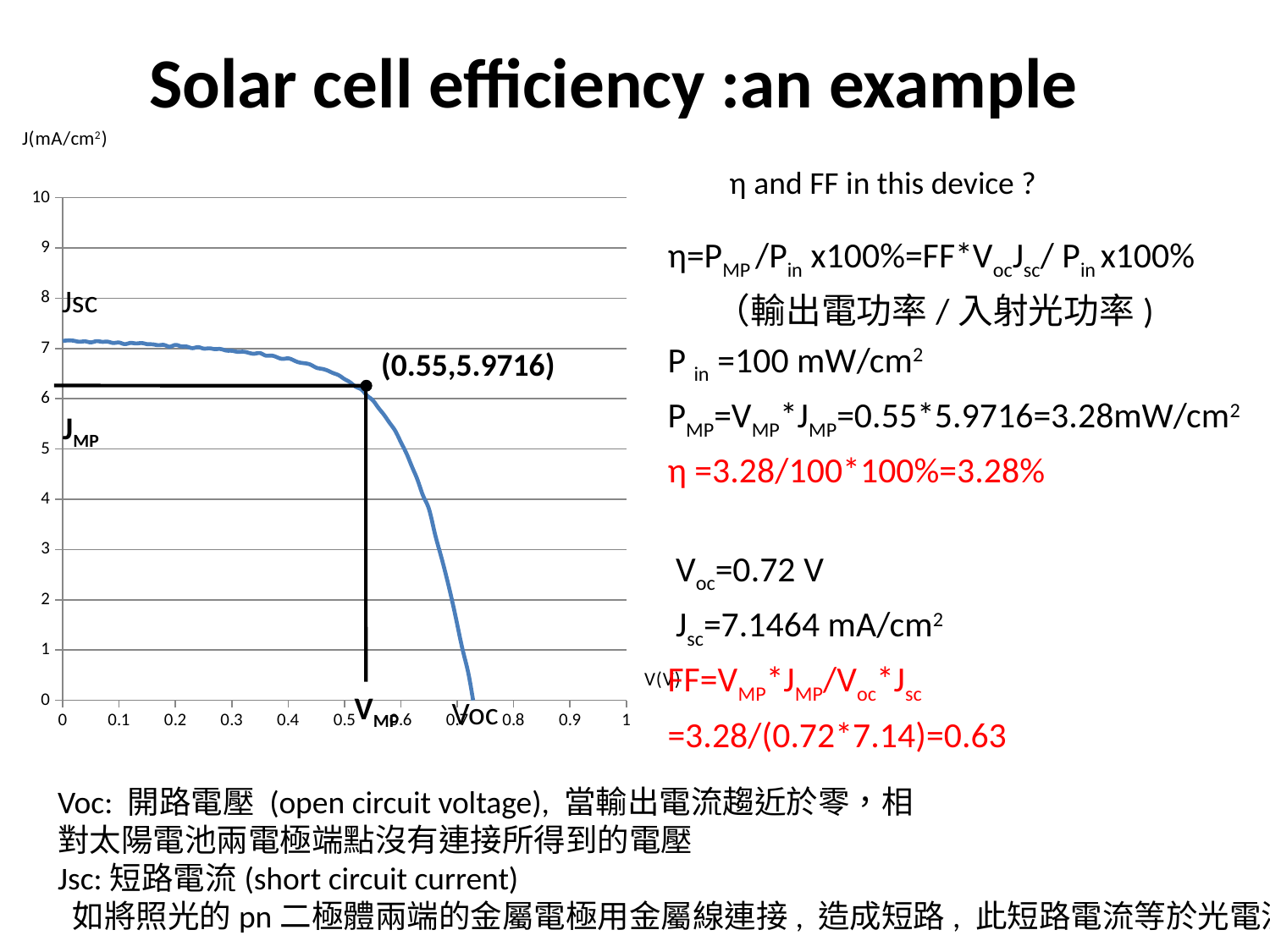
Is the current density at V = 0.7 greater or less than 3 on the y axis? less What are the coordinates of the labelled maximum power point on the J-V curve? (0.55, 5.9716) According to the slide, what is the short circuit current density Jsc of this device? 7.1464 mA/cm2 What is the label of the y axis of the chart? J(mA/cm2) Does the current density J rise or fall as the voltage increases along the x axis? fall What is the maximum value shown on the y axis of the chart? 10 What kind of chart is shown on the slide? line chart What is the current density J at the maximum power point marked on the chart? 5.9716 Is the current density at V = 0 greater or less than 5 on the y axis? greater What is the voltage V_MP at the maximum power point marked on the chart? 0.55 Is the current density at V = 0.3 greater or less than 6 on the y axis? greater According to the slide, what is the open circuit voltage Voc of this device? 0.72 V